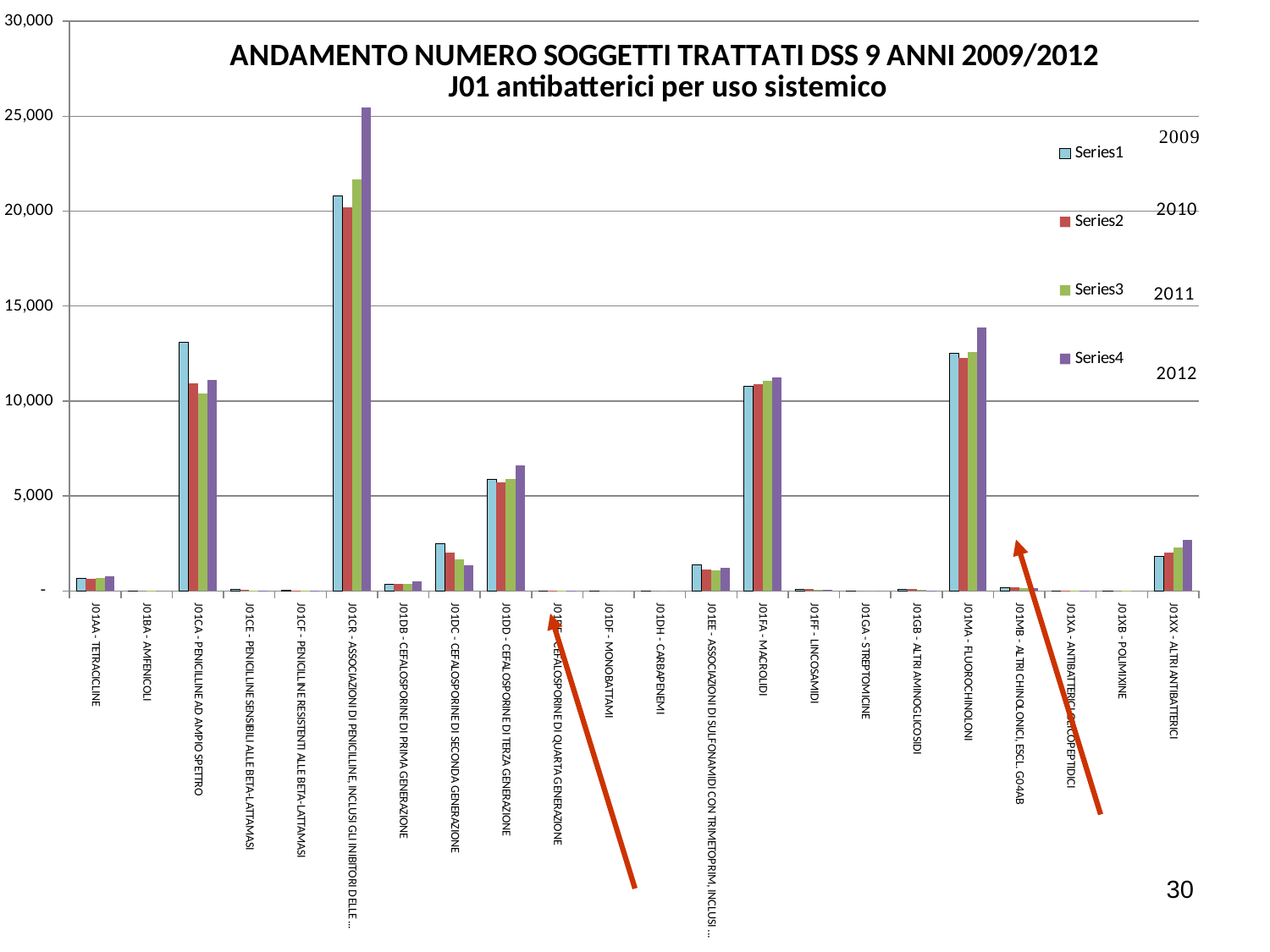
For J01CA - PENICILLINE AD AMPIO SPETTRO, which is larger: the Series1 value or the Series4 value? Series1 What colour are the Series4 bars? purple Is the Series1 value for J01CA - PENICILLINE AD AMPIO SPETTRO greater or less than 10,000? greater Which category has the highest bars overall? J01CR - ASSOCIAZIONI DI PENICILLINE, INCLUSI GLI INIBITORI DELLE... Is the Series4 value for J01MA - FLUOROCHINOLONI greater or less than 15,000? less How many categories are shown along the x axis? 22 Do the values for J01XX - ALTRI ANTIBATTERICI rise or fall from Series1 to Series4? rise Is the Series4 value for J01DD - CEFALOSPORINE DI TERZA GENERAZIONE greater or less than 5,000? greater For J01MA - FLUOROCHINOLONI, which is larger: the Series1 value or the Series4 value? Series4 How many series does the legend list? 4 What kind of chart is shown on the slide? bar chart